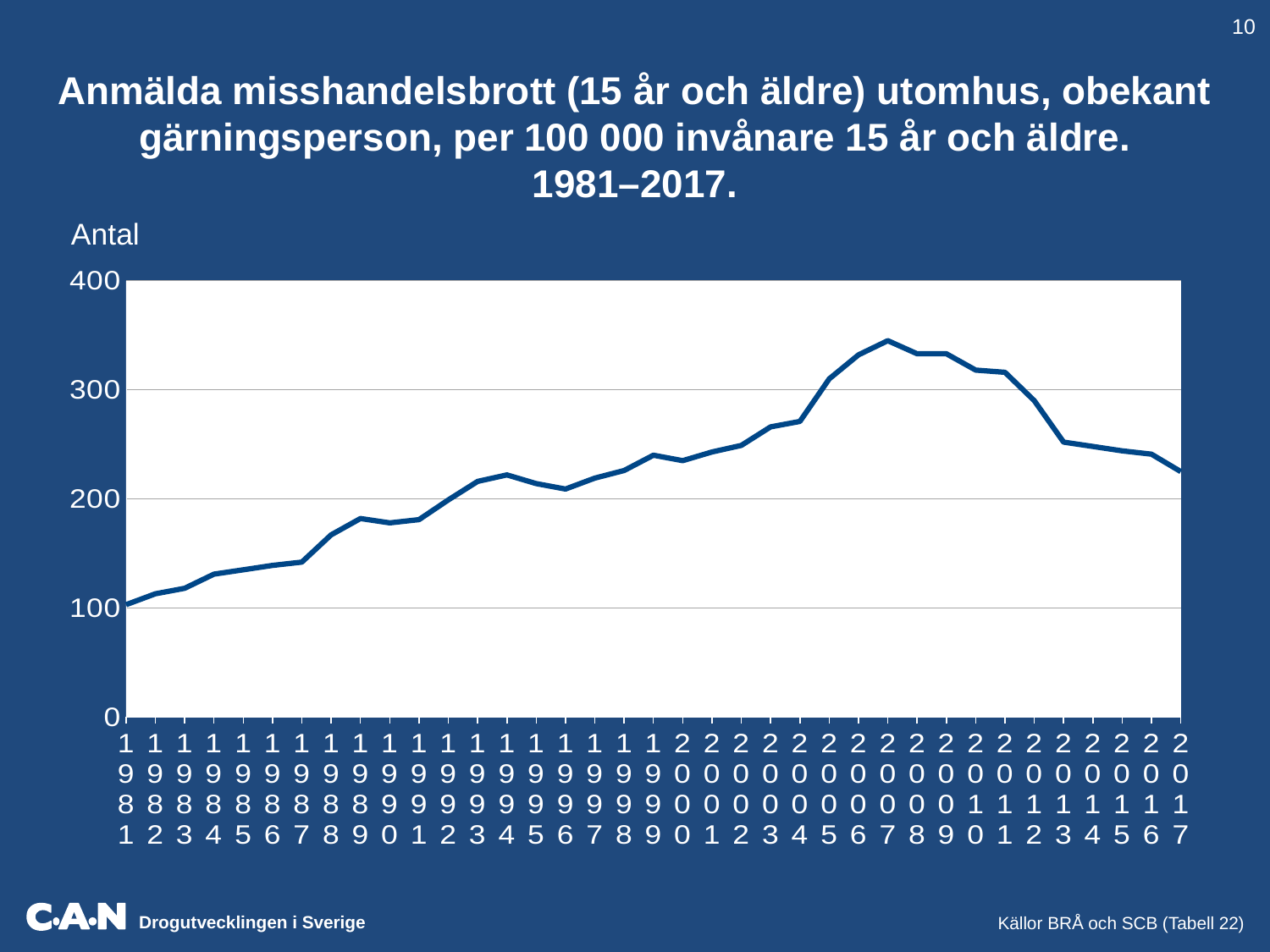
In which year does the line reach its highest value? 2007 How many years are plotted along the x axis? 37 Is the value for 1990 greater or less than 200? less Which year has the larger value, 2010 or 2017? 2010 Is the value for 2007 greater or less than 300? greater Is the value for 2017 greater or less than 200? greater Does the line generally rise or fall between 1981 and 2007? rise What kind of chart is shown on the slide? line chart In which year is the plotted value lowest? 1981 What label is shown on the vertical axis? Antal